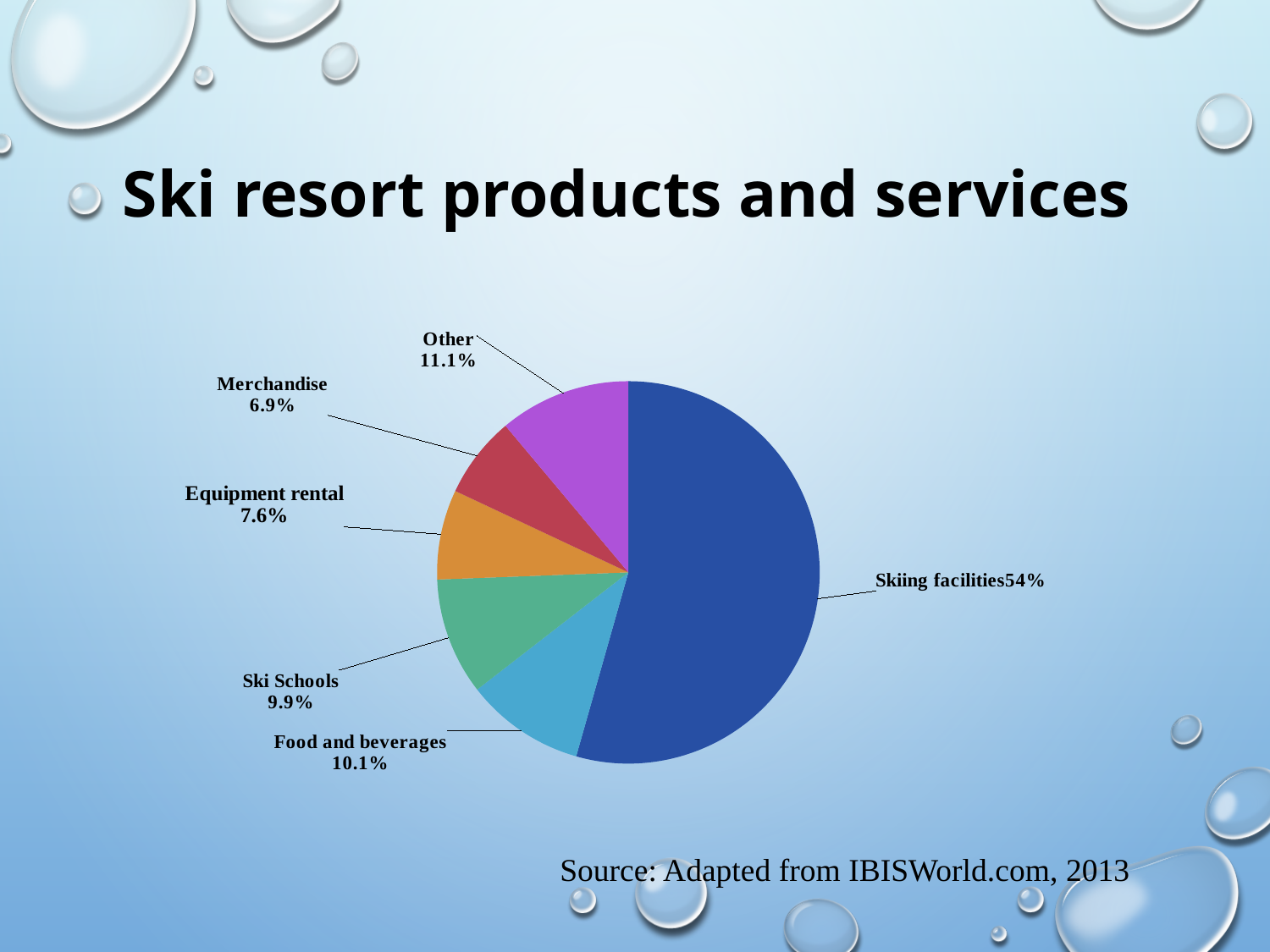
What is the value for Other? 11.1% What share of the pie does Skiing facilities represent? 54% Which is larger, the share for Equipment rental or the share for Ski Schools? Ski Schools Which category has the largest share of the pie? Skiing facilities How many categories are shown in the pie chart? 6 What is the value for Ski Schools? 9.9% What is the value for Food and beverages? 10.1% What is the difference between the shares for Other and Merchandise? 4.2% What type of chart is shown on the slide? pie chart What is the value for Equipment rental? 7.6% Which category has the smallest share of the pie? Merchandise What is the value for Merchandise? 6.9%